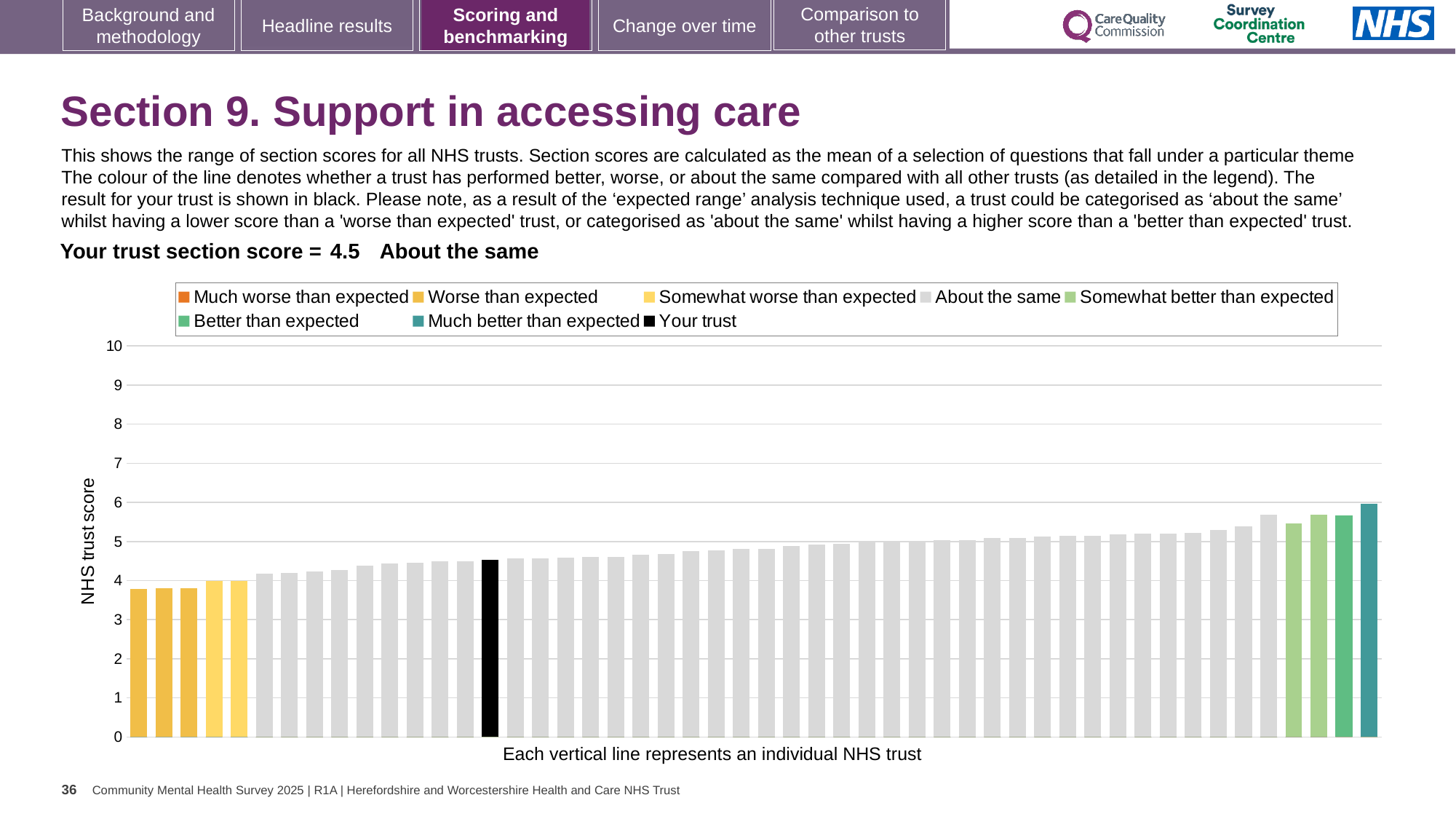
Is the value of the tallest bar (the rightmost, teal bar) greater or less than 5? greater What is the label of the y axis? NHS trust score Is the value of the black 'Your trust' bar greater or less than 5? less Is the value of the black 'Your trust' bar greater or less than 4? greater How is your trust's section score categorised compared with other trusts? About the same What kind of chart is shown on the slide? bar chart What is the section score for your trust, as printed on the slide? 4.5 How many entries does the chart legend list? 8 Do the bar values rise or fall from left to right along the x axis? rise Which colour is used for the 'Your trust' bar according to the legend? black What is the maximum value shown on the y axis? 10